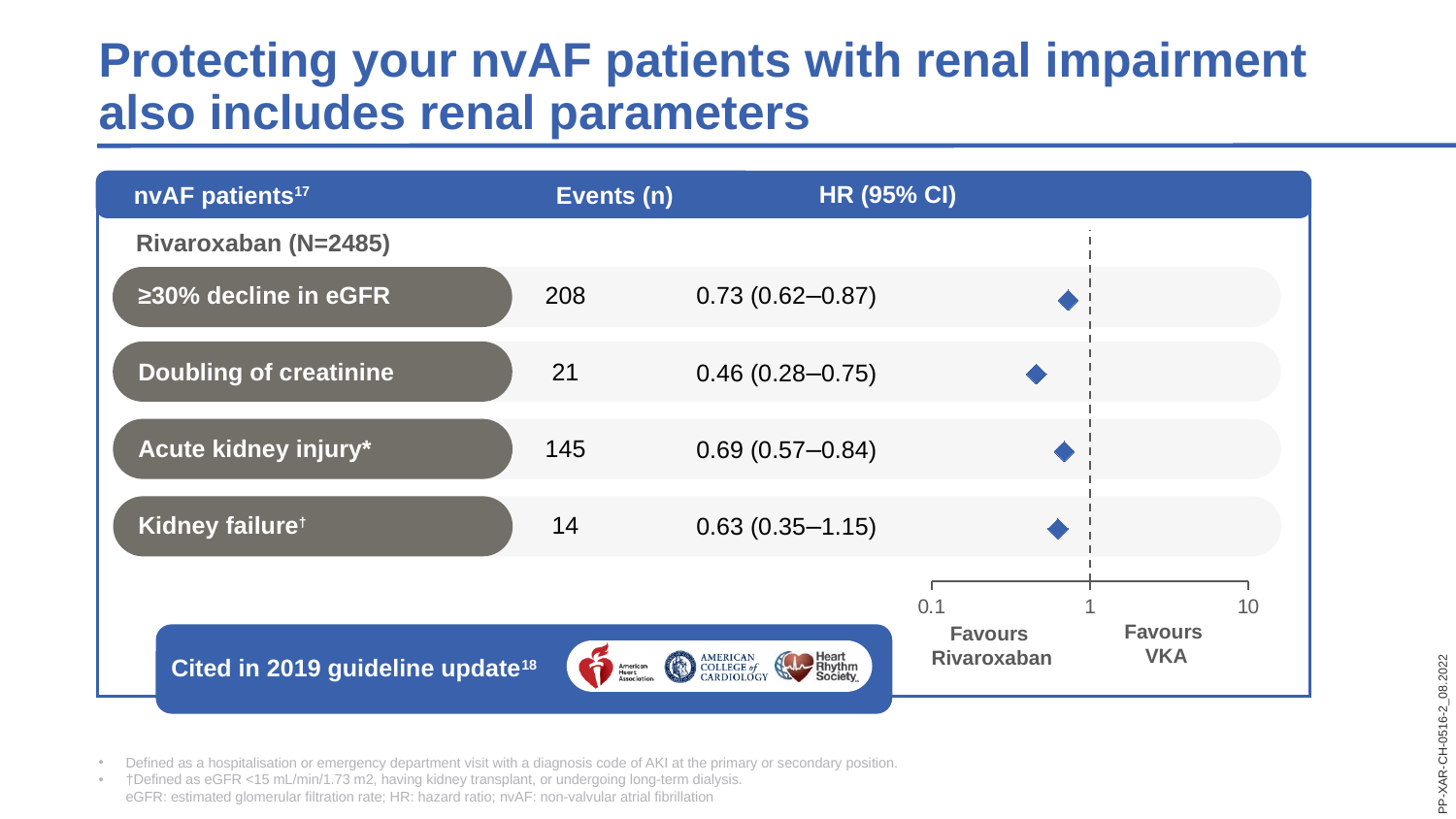
What is the HR (95% CI) for ≥30% decline in eGFR? 0.73 (0.62–0.87) What is the HR (95% CI) for doubling of creatinine? 0.46 (0.28–0.75) What is the number of rivaroxaban patients (N) shown in the chart? 2485 How many renal outcomes are plotted in the forest plot? 4 What kind of chart is shown on the slide? Forest plot How many events (n) are reported for kidney failure? 14 What is the difference in events between ≥30% decline in eGFR and acute kidney injury? 63 Which outcome has the lowest hazard ratio point estimate? Doubling of creatinine Which outcome has the highest number of events? ≥30% decline in eGFR Is the hazard ratio point estimate for acute kidney injury greater or less than 1? less How many events (n) are reported for acute kidney injury? 145 Which has more events: doubling of creatinine or kidney failure? Doubling of creatinine